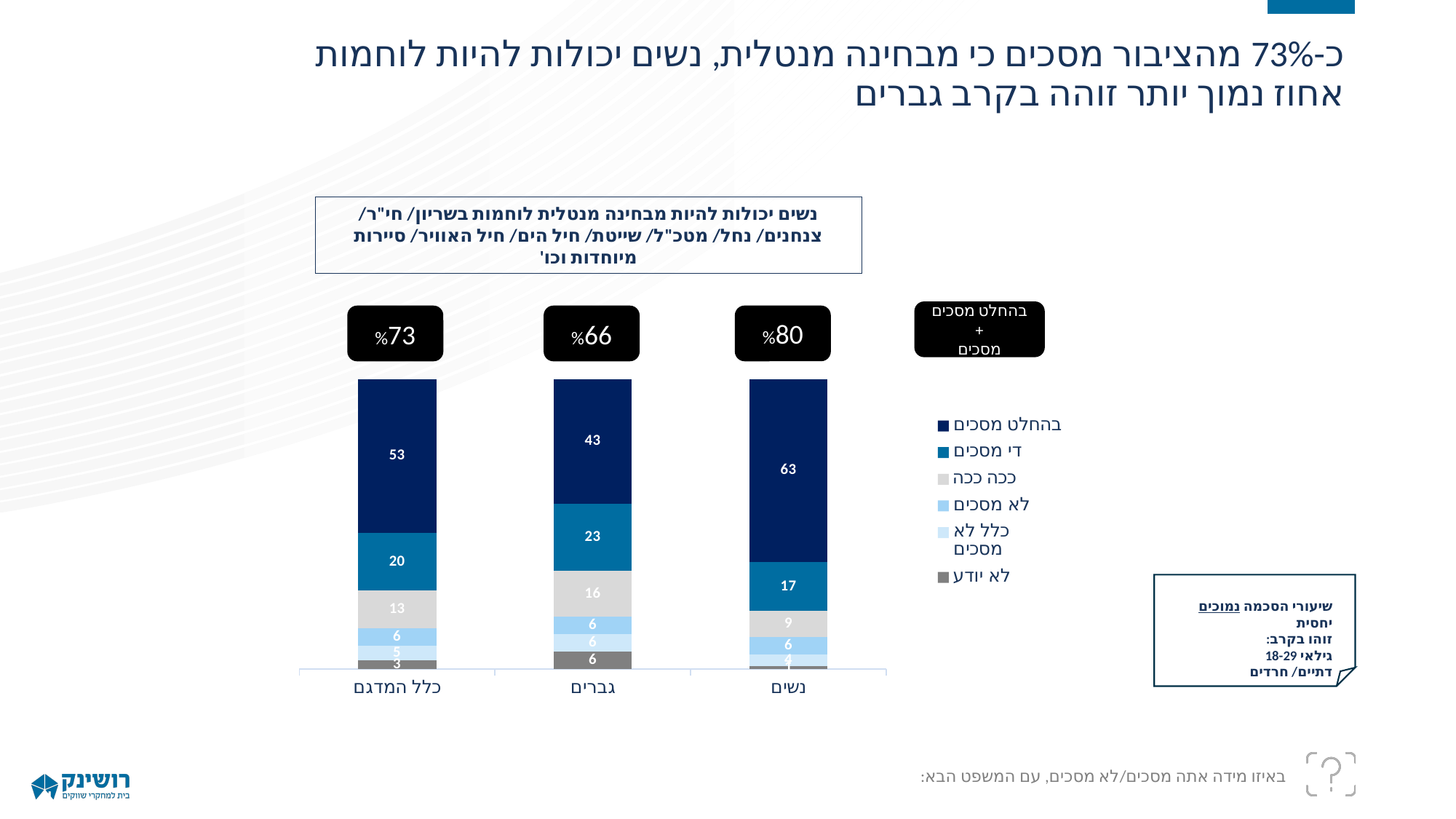
What is the value of the 'ככה ככה' segment for 'כלל המדגם'? 13 Which is larger: the 'די מסכים' value for 'גברים' or for 'נשים'? גברים How many categories are shown on the x axis of the chart? 3 Which category has the lowest 'בהחלט מסכים' value? גברים How many series does the chart legend list? 6 What type of chart is shown on the slide? Stacked bar chart What is the value of the 'בהחלט מסכים' segment for 'נשים'? 63 What is the total of the stacked bar for 'גברים'? 100 What combined percentage ('בהחלט מסכים + מסכים') is shown above the 'גברים' bar? 66% What is the difference between the 'בהחלט מסכים' values for 'נשים' and 'גברים'? 20 What is the value of the 'די מסכים' segment for 'גברים'? 23 Which category has the highest 'בהחלט מסכים' value? נשים